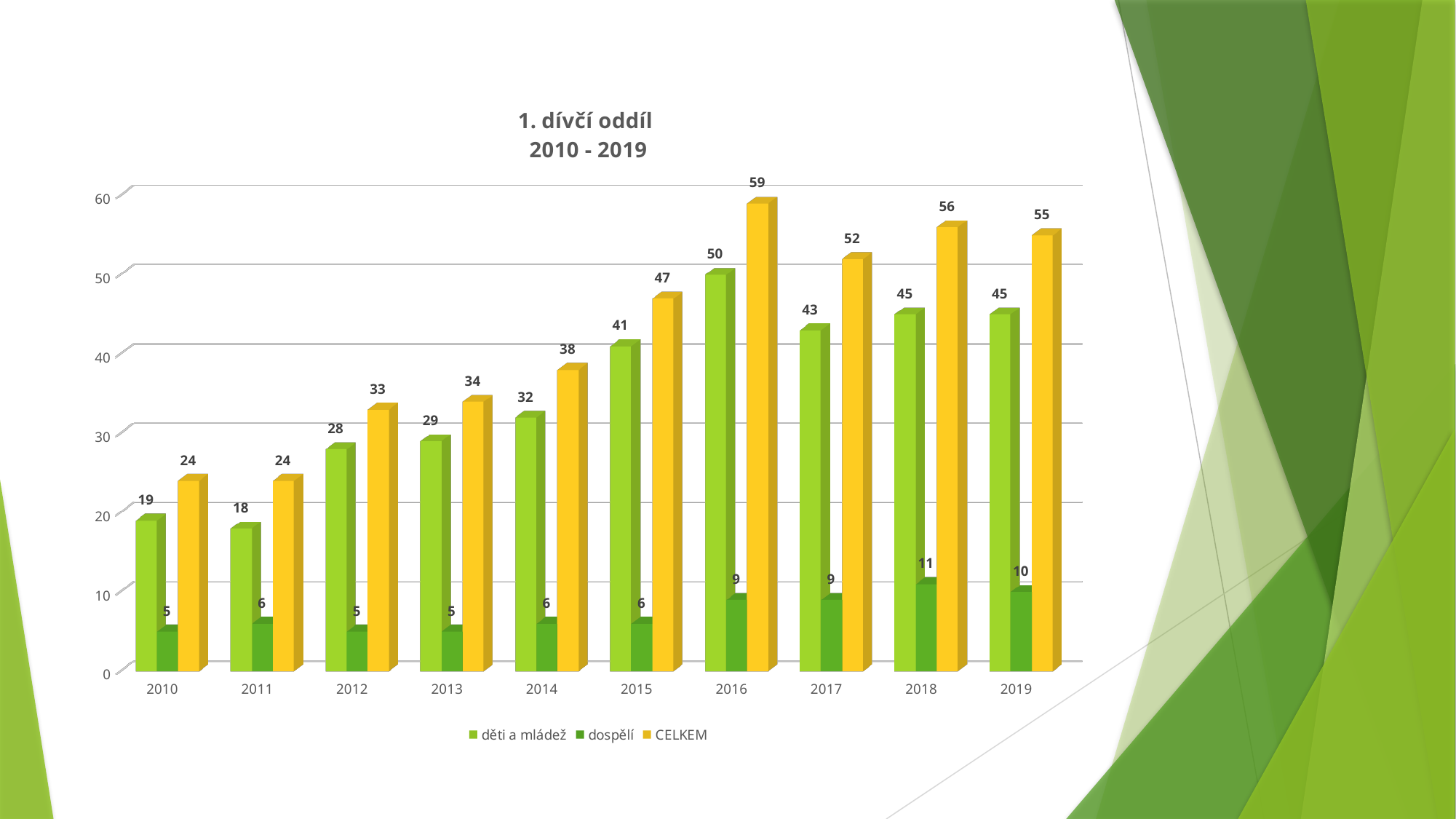
What is the difference between the CELKEM values for 2019 and 2010? 31 What kind of chart is shown on the slide? bar chart Does the CELKEM value generally rise or fall from 2010 to 2016? rise What is the title of the chart? 1. dívčí oddíl 2010 - 2019 Which is larger, the děti a mládež value in 2016 or in 2017? 2016 How many years are shown on the x axis? 10 What is the value for dospělí in 2018? 11 How many series does the legend list? 3 In which year is the CELKEM value highest? 2016 What is the value for děti a mládež in 2013? 29 In which year is the děti a mládež value lowest? 2011 What is the value for CELKEM in 2016? 59